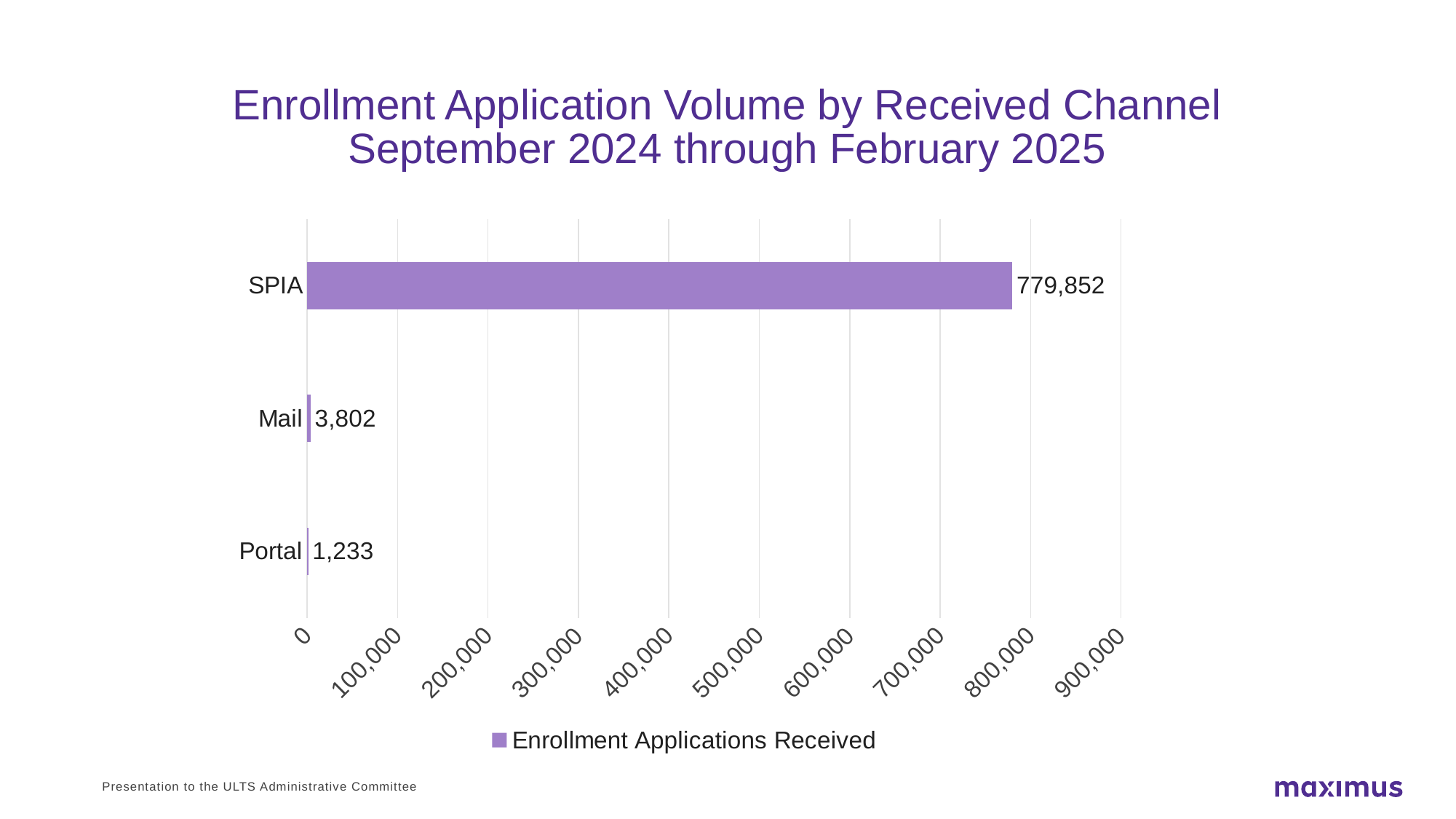
What is the value for SPIA? 779,852 How many channels are shown on the chart? 3 What is the difference between the values for SPIA and Mail? 776,050 What kind of chart is shown on the slide? Bar chart What is the difference between the values for Mail and Portal? 2,569 What is the value for Portal? 1,233 Is the value for SPIA greater or less than 700,000? greater What series name does the legend show? Enrollment Applications Received Which channel has the highest number of enrollment applications received? SPIA Which is larger, the value for Mail or the value for Portal? Mail Which channel has the lowest number of enrollment applications received? Portal What is the value for Mail? 3,802